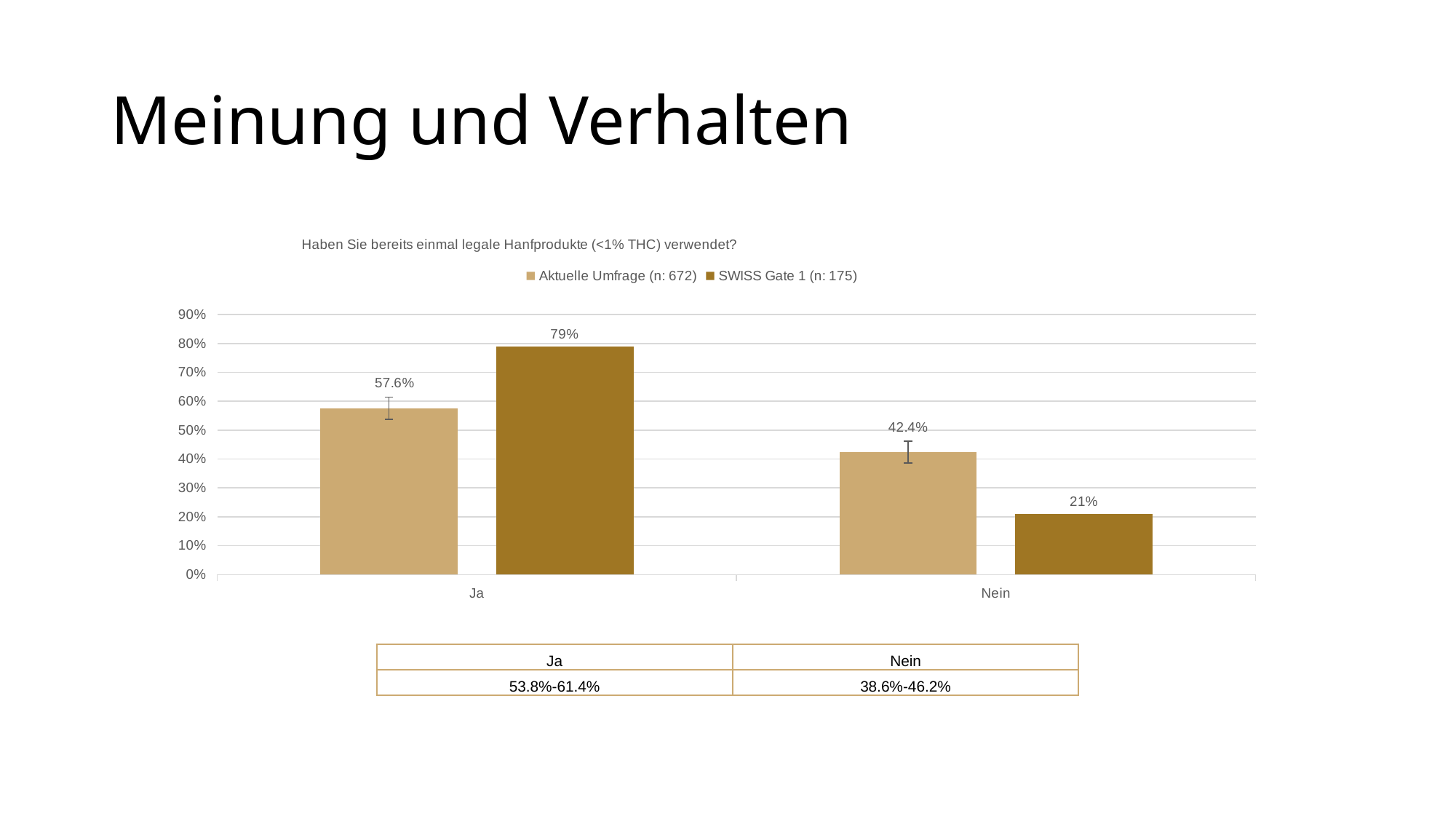
What is the value for "Nein" in the "SWISS Gate 1 (n: 175)" series? 21% For "Nein", which series has the larger value: "Aktuelle Umfrage (n: 672)" or "SWISS Gate 1 (n: 175)"? Aktuelle Umfrage (n: 672) What is the difference between the "Aktuelle Umfrage (n: 672)" and "SWISS Gate 1 (n: 175)" values for "Nein"? 21.4% Which category has the lowest value in the "Aktuelle Umfrage (n: 672)" series? Nein What is the value for "Ja" in the "SWISS Gate 1 (n: 175)" series? 79% What is the difference between the "SWISS Gate 1 (n: 175)" and "Aktuelle Umfrage (n: 672)" values for "Ja"? 21.4% What is the value for "Nein" in the "Aktuelle Umfrage (n: 672)" series? 42.4% What is the value for "Ja" in the "Aktuelle Umfrage (n: 672)" series? 57.6% How many categories are shown on the x axis? 2 How many series does the legend list? 2 What kind of chart is shown on the slide? Bar chart Which category has the highest value in the "SWISS Gate 1 (n: 175)" series? Ja